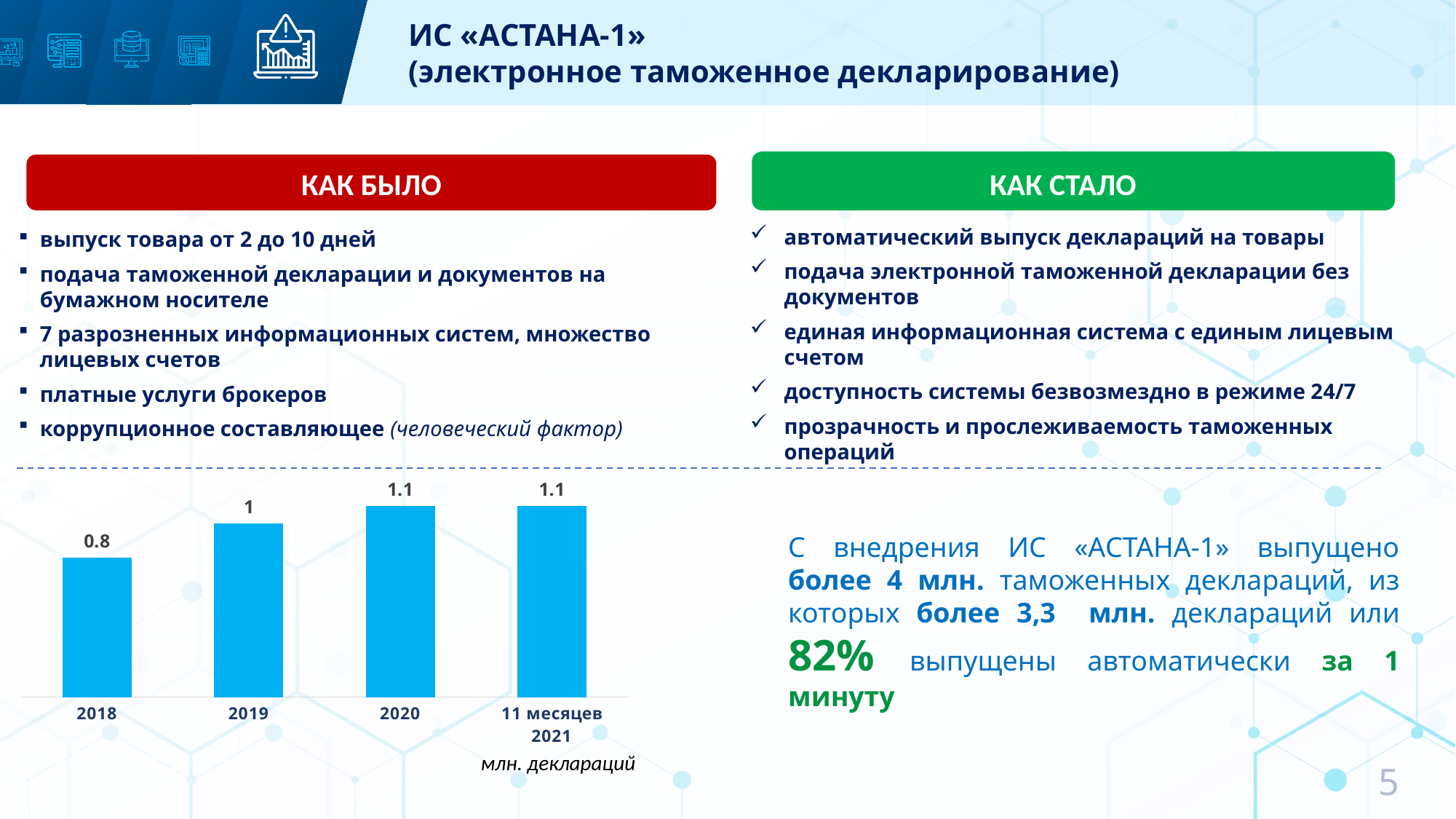
Do the values in the bar chart rise or fall from 2018 to 2020? rise What is the difference between the values for 2020 and 2018? 0.3 How many categories are shown in the bar chart? 4 What is the value for 2019 in the bar chart? 1 Which category has the lowest value in the bar chart? 2018 What is the value for 2020 in the bar chart? 1.1 What kind of chart is shown on the slide? bar chart What is the difference between the values for 2019 and 2018? 0.2 What unit is indicated below the bar chart? млн. деклараций Which is larger, the value for 2019 or the value for 2018? 2019 What is the value for 2018 in the bar chart? 0.8 What is the value for 11 месяцев 2021 in the bar chart? 1.1